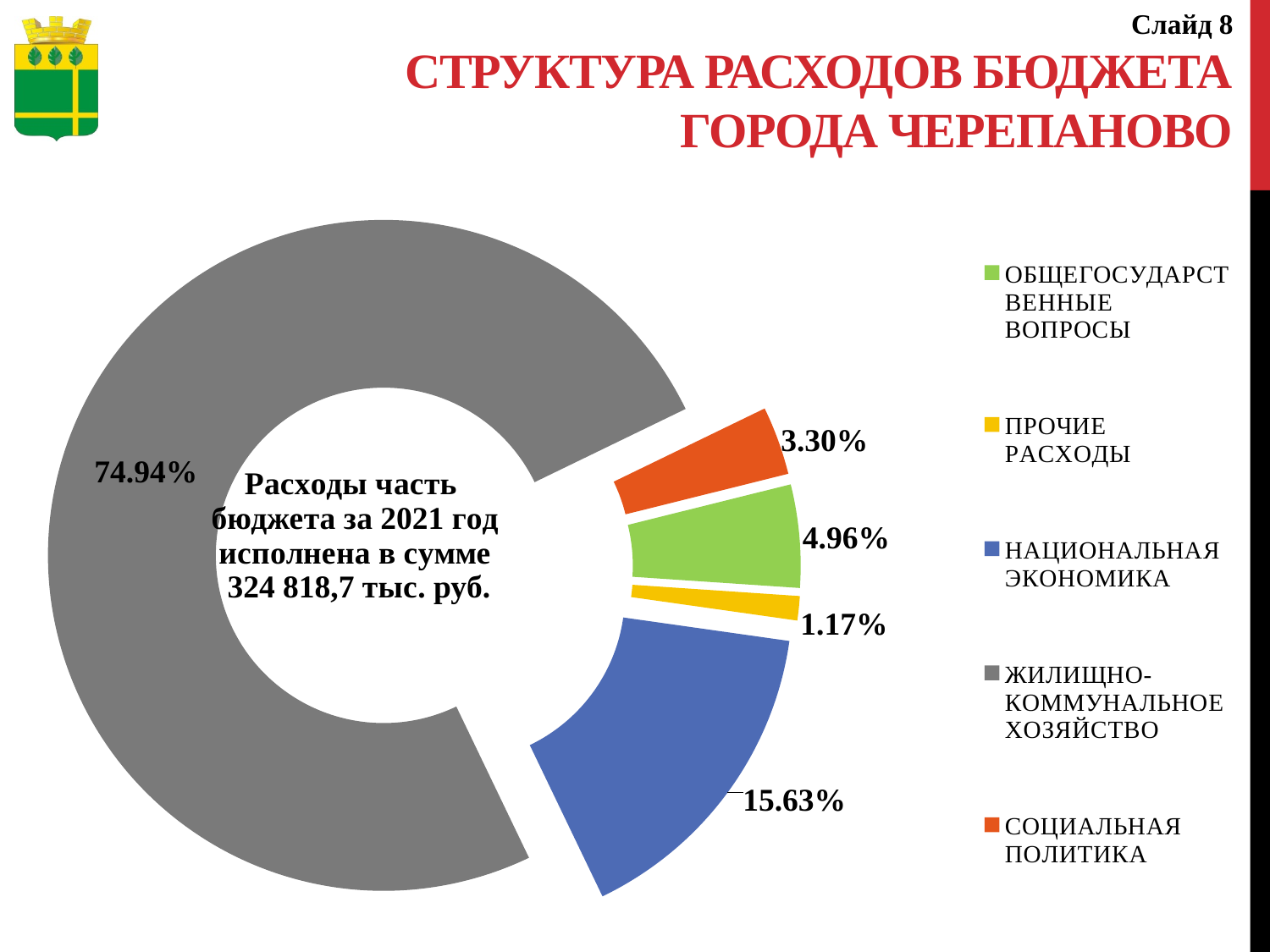
Which category has the smallest share of the budget expenditure? ПРОЧИЕ РАСХОДЫ What colour represents НАЦИОНАЛЬНАЯ ЭКОНОМИКА in the chart? Blue What share of budget expenditure is СОЦИАЛЬНАЯ ПОЛИТИКА? 3.30% What share of budget expenditure is ЖИЛИЩНО-КОММУНАЛЬНОЕ ХОЗЯЙСТВО? 74.94% Which category has the largest share of the budget expenditure? ЖИЛИЩНО-КОММУНАЛЬНОЕ ХОЗЯЙСТВО Which is larger: the share for ОБЩЕГОСУДАРСТВЕННЫЕ ВОПРОСЫ or for СОЦИАЛЬНАЯ ПОЛИТИКА? ОБЩЕГОСУДАРСТВЕННЫЕ ВОПРОСЫ What type of chart is shown on the slide? Doughnut (pie) chart What share of budget expenditure is НАЦИОНАЛЬНАЯ ЭКОНОМИКА? 15.63% What share of budget expenditure is ПРОЧИЕ РАСХОДЫ? 1.17% What share of budget expenditure is ОБЩЕГОСУДАРСТВЕННЫЕ ВОПРОСЫ? 4.96% How many categories does the chart show? 5 What is the difference in percentage points between the shares for ЖИЛИЩНО-КОММУНАЛЬНОЕ ХОЗЯЙСТВО and НАЦИОНАЛЬНАЯ ЭКОНОМИКА? 59.31 percentage points